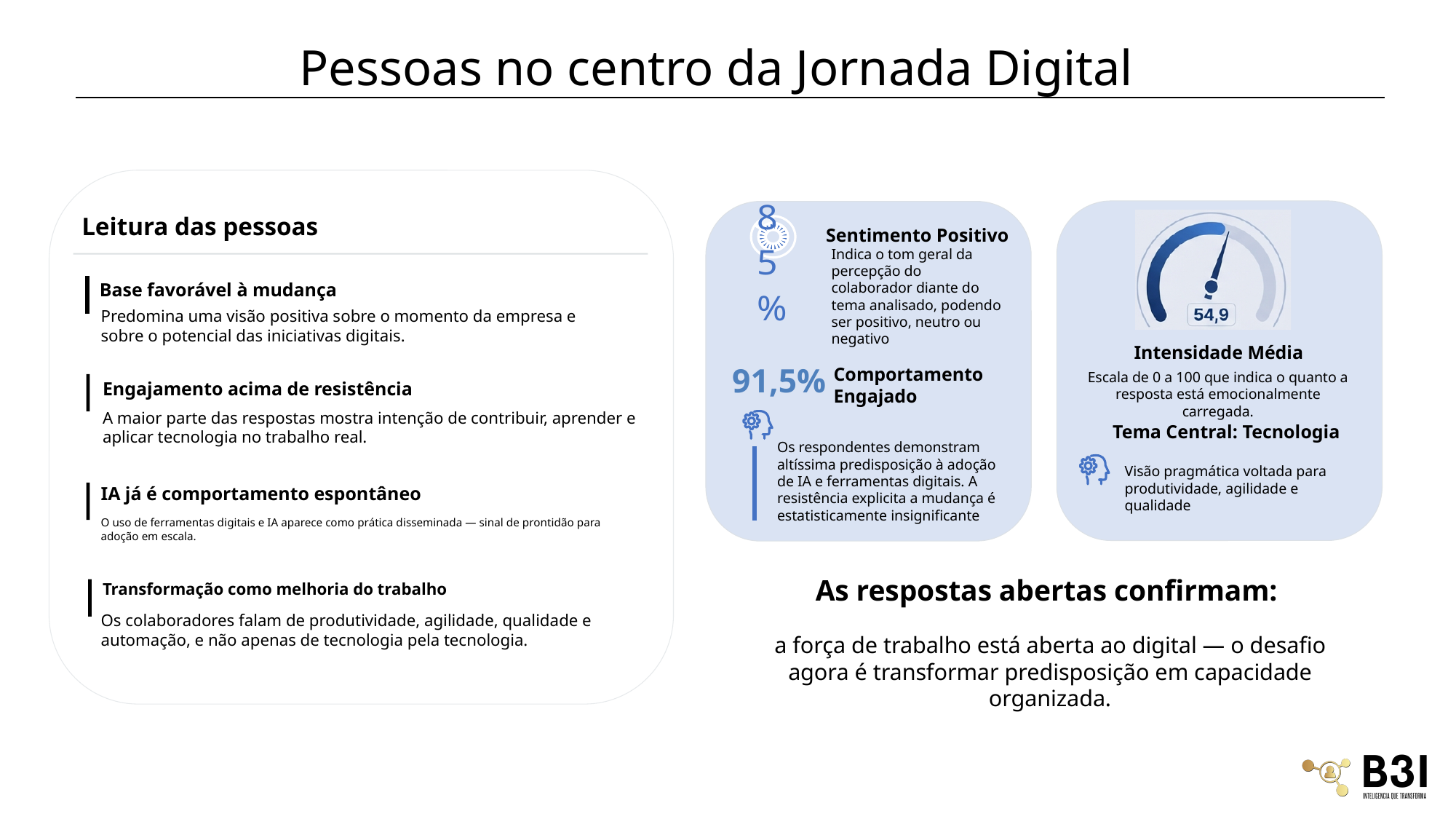
What is the range of the scale used by the "Intensidade Média" gauge, according to the slide? 0 a 100 What value does the gauge chart under "Intensidade Média" display? 54,9 What kind of chart is shown above the "Intensidade Média" label? gauge chart Is the value shown on the "Intensidade Média" gauge greater or less than 100? less What is the title printed directly below the gauge chart? Intensidade Média Is the value shown on the "Intensidade Média" gauge greater or less than 50? greater